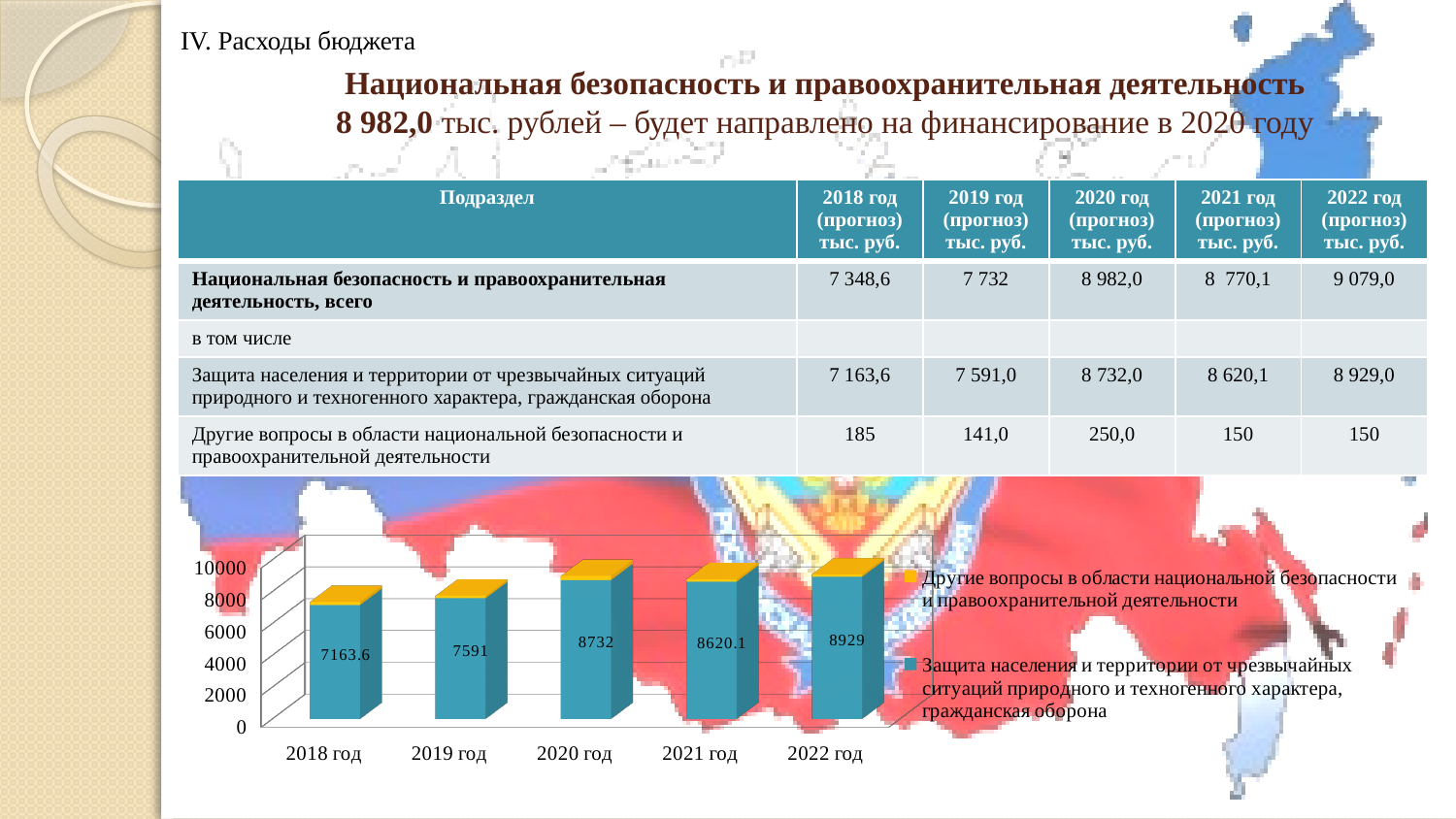
Which year has the lowest value for 'Защита населения и территории от чрезвычайных ситуаций' in the chart? 2018 год What kind of chart is shown at the bottom of the slide? bar chart How many year categories are shown on the x axis of the chart? 5 What is the value for 2020 год for the series 'Защита населения и территории от чрезвычайных ситуаций природного и техногенного характера, гражданская оборона' in the chart? 8732 How many series does the chart legend list? 2 What is the value labelled on the 2018 год bar for 'Защита населения и территории от чрезвычайных ситуаций' in the chart? 7163.6 What is the value labelled on the 2022 год bar for 'Защита населения и территории от чрезвычайных ситуаций' in the chart? 8929 Is the total height of the 2020 год stacked bar greater or less than 8000? greater What is the difference between the 2022 год and 2018 год values for 'Защита населения и территории от чрезвычайных ситуаций' in the chart? 1765.4 Which is larger in the chart for 'Защита населения и территории от чрезвычайных ситуаций': the 2020 год value or the 2021 год value? 2020 год Do the values for 'Защита населения и территории от чрезвычайных ситуаций' rise or fall from 2018 год to 2020 год in the chart? rise Which year has the highest value for 'Защита населения и территории от чрезвычайных ситуаций' in the chart? 2022 год